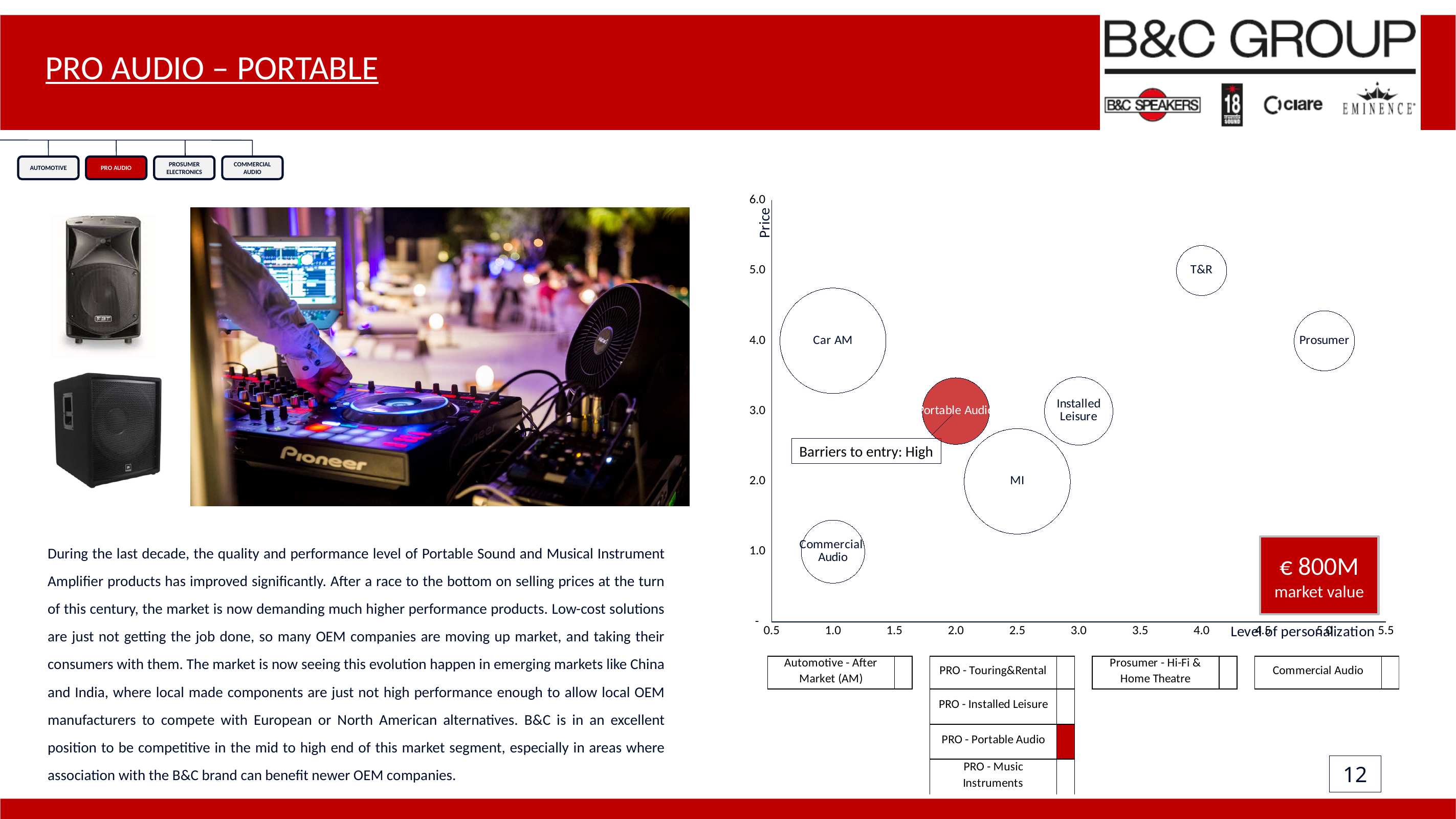
What is the label of the vertical axis of the chart? Price Which segment has the lowest price on the chart? Commercial Audio How many bubbles (market segments) are plotted on the chart? 7 Is the price for Commercial Audio greater or less than 2.0? less Is the price for T&R greater or less than 4.0? greater Is the level of personalization for Car AM greater or less than 2.0? less Which has the higher price, Car AM or MI? Car AM Which segment has the highest price on the chart? T&R What kind of chart is shown on the slide? bubble chart Which segment has the highest level of personalization on the chart? Prosumer Which bubble on the chart is highlighted in red? Portable Audio